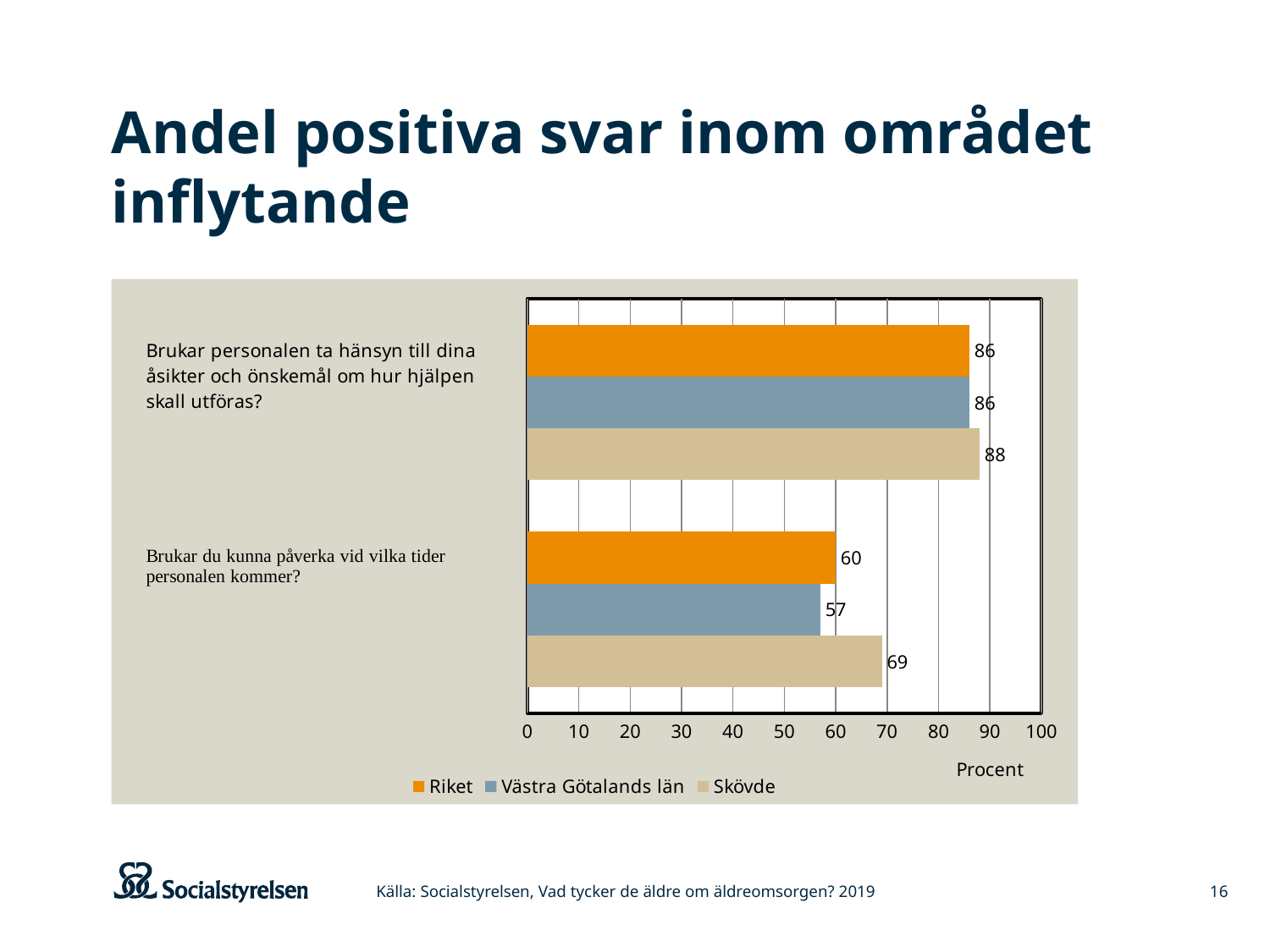
What is the label on the horizontal axis of the chart? Procent Which is larger: the Riket value or the Västra Götalands län value on the question "Brukar du kunna påverka vid vilka tider personalen kommer?"? Riket How many series does the legend list? 3 What is the difference between the Skövde and Riket values on the question "Brukar du kunna påverka vid vilka tider personalen kommer?"? 9 Which series has the lowest value on the question "Brukar du kunna påverka vid vilka tider personalen kommer?"? Västra Götalands län How many questions (categories) are shown on the chart? 2 What kind of chart is shown on the slide? Bar chart What is the difference between the Skövde and Västra Götalands län values on the question "Brukar personalen ta hänsyn till dina åsikter och önskemål om hur hjälpen skall utföras?"? 2 Which series has the highest value on the question "Brukar du kunna påverka vid vilka tider personalen kommer?"? Skövde What is the value for Västra Götalands län on the question "Brukar du kunna påverka vid vilka tider personalen kommer?"? 57 What is the value for Riket on the question "Brukar personalen ta hänsyn till dina åsikter och önskemål om hur hjälpen skall utföras?"? 86 What is the value for Skövde on the question "Brukar du kunna påverka vid vilka tider personalen kommer?"? 69